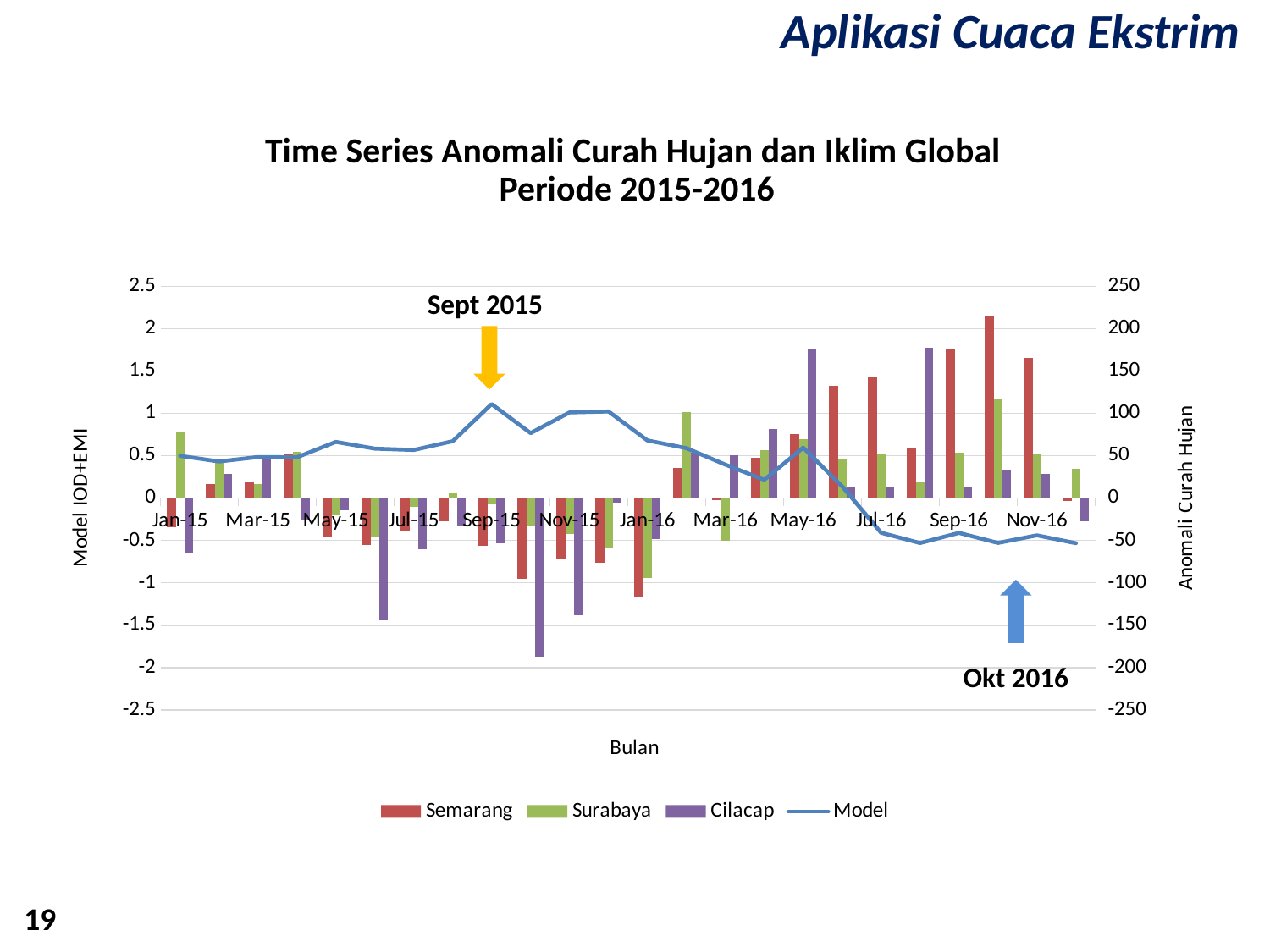
Which series is drawn as a line rather than bars? Model Is the Cilacap value at May-16 greater or less than 150? greater How many series does the legend list? 4 What is the title of the chart? Time Series Anomali Curah Hujan dan Iklim Global Periode 2015-2016 Is the Semarang value at Jul-16 greater or less than 100? greater How many month labels are shown along the x axis? 12 Is the Model value at Sep-15 greater or less than 1? greater What kind of chart is shown on the slide? A combination bar and line chart Does the Model line rise or fall between Jan-16 and Sep-16? Fall At Jul-16, which is larger, the Semarang bar or the Surabaya bar? Semarang At which labelled month does the Model line reach its highest value? Sep-15